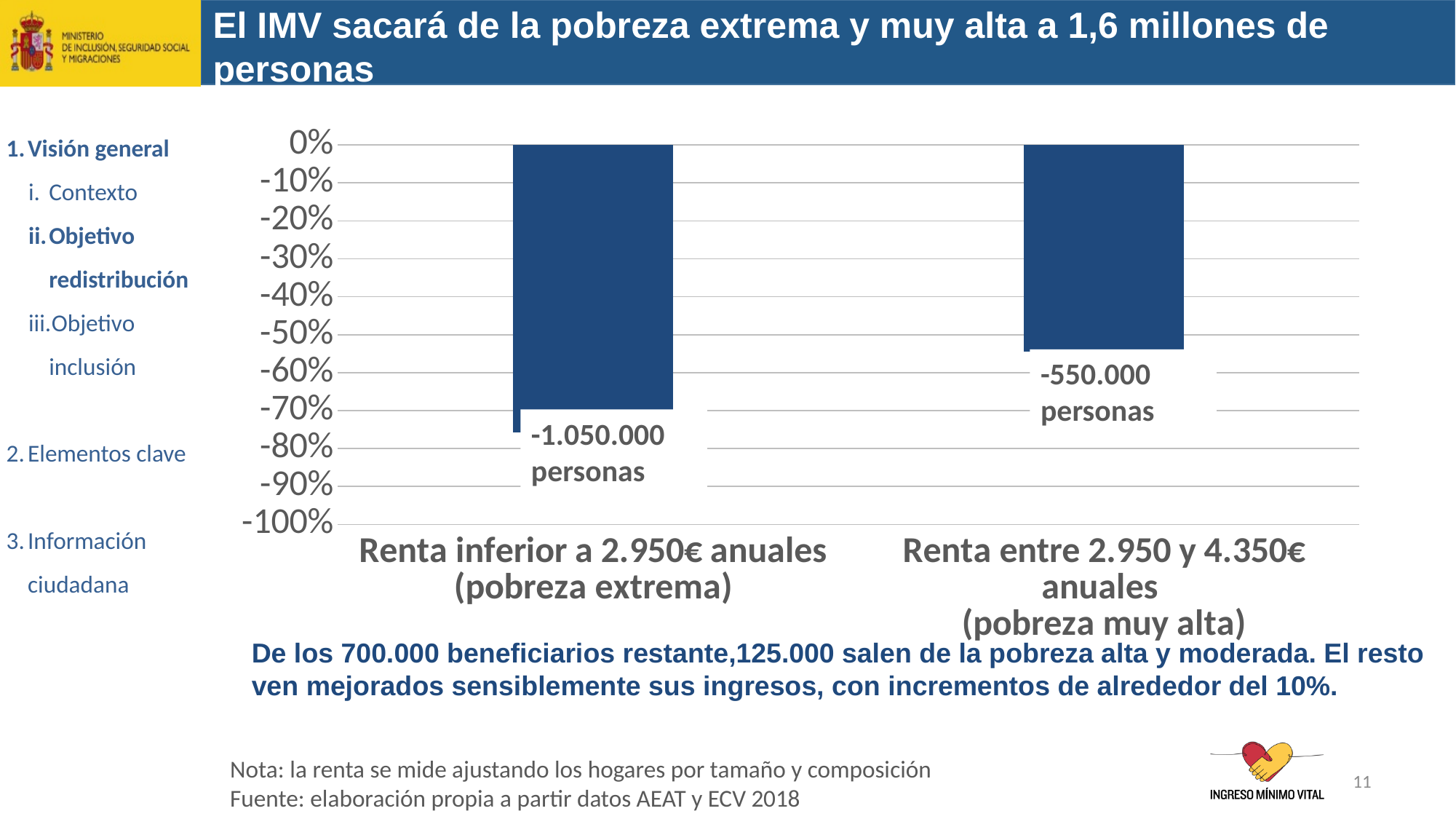
Which category shows the larger number of people leaving poverty, "pobreza extrema" or "pobreza muy alta"? Renta inferior a 2.950€ anuales (pobreza extrema) Is the percentage value for "Renta entre 2.950 y 4.350€ anuales (pobreza muy alta)" greater or less than -60%? greater What kind of chart is shown on the slide? Bar chart Which category has the bar that extends furthest below 0%? Renta inferior a 2.950€ anuales (pobreza extrema) How many categories are plotted on the chart? 2 What data label is shown on the bar for "Renta inferior a 2.950€ anuales (pobreza extrema)"? -1.050.000 personas What is the lowest value shown on the chart's vertical axis? -100% What is the difference in number of people between the two bars' data labels (1.050.000 and 550.000)? 500.000 personas What data label is shown on the bar for "Renta entre 2.950 y 4.350€ anuales (pobreza muy alta)"? -550.000 personas Is the percentage value for "Renta entre 2.950 y 4.350€ anuales (pobreza muy alta)" greater or less than -50%? less What is the title of the slide containing the chart? El IMV sacará de la pobreza extrema y muy alta a 1,6 millones de personas Is the percentage value for "Renta inferior a 2.950€ anuales (pobreza extrema)" greater or less than -50%? less